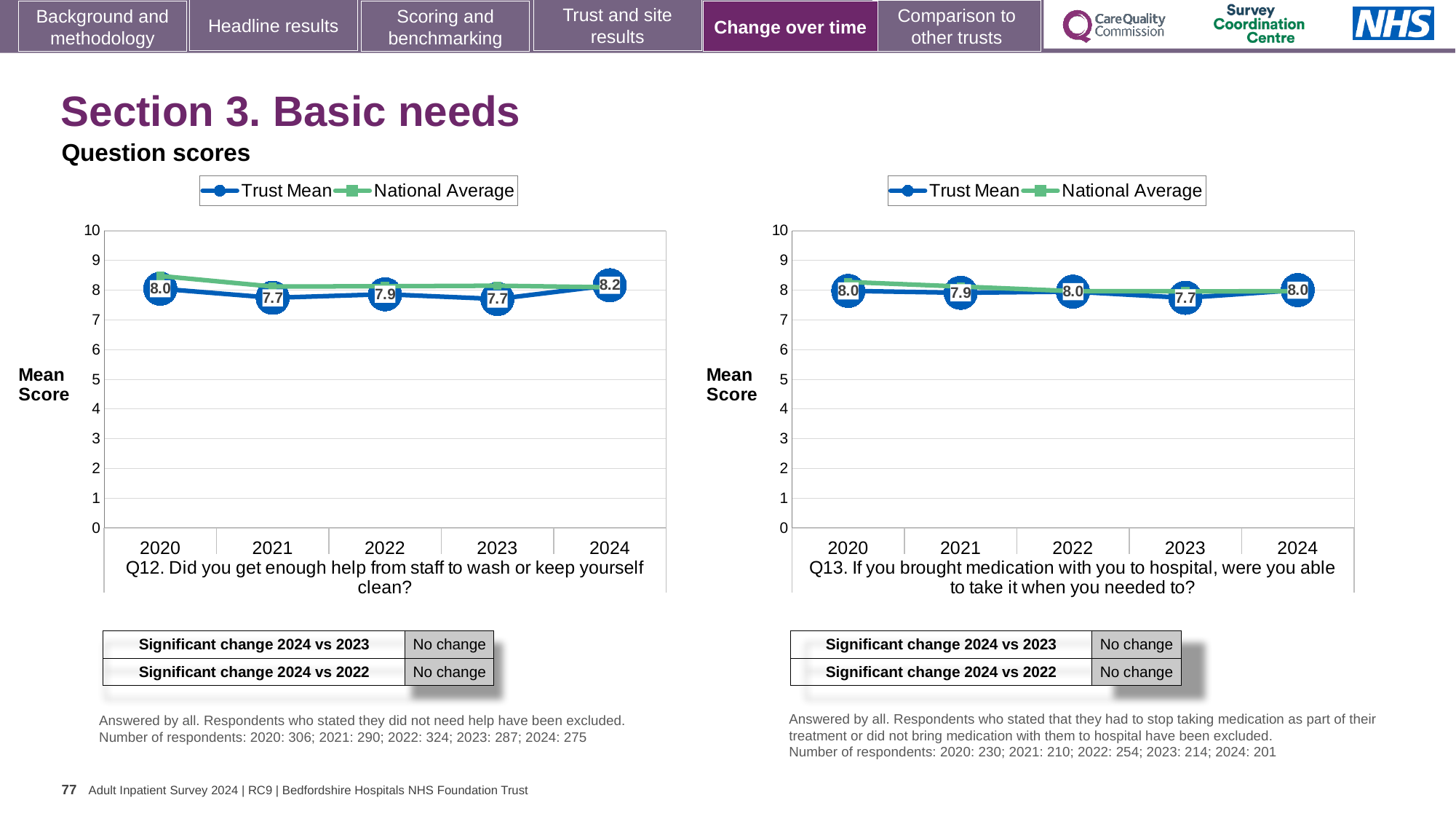
In the Q12 chart (left), what is the Trust Mean score for 2021? 7.7 In the Q13 chart (right), which year has the lowest Trust Mean score? 2023 How many years are plotted on the x axis of the Q13 chart (right)? 5 In the Q13 chart (right), what is the Trust Mean score for 2020? 8.0 In the Q13 chart (right), which is larger, the Trust Mean score for 2022 or for 2023? 2022 In the Q12 chart (left), what is the Trust Mean score for 2024? 8.2 In the Q12 chart (left), which year has the highest Trust Mean score? 2024 How many series does the legend of the Q12 chart (left) list? 2 In the Q12 chart (left), is the National Average for 2020 greater or less than 8? greater In the Q12 chart (left), what is the difference between the Trust Mean scores for 2024 and 2023? 0.5 In the Q13 chart (right), what is the Trust Mean score for 2023? 7.7 What type of chart is the Q12 chart (left)? Line chart